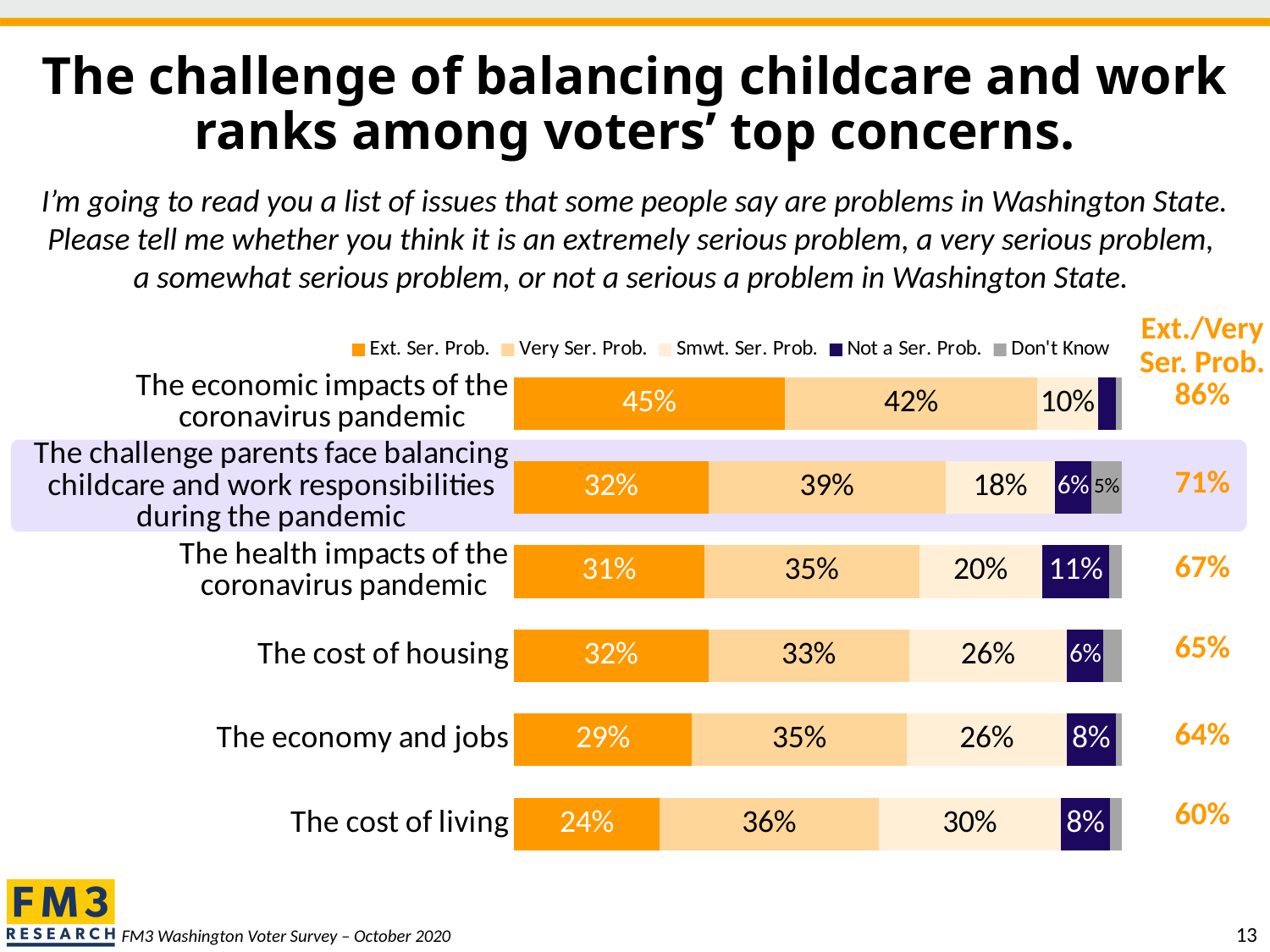
What kind of chart is shown on the slide? Stacked bar chart What is the difference between the Ext./Very Ser. Prob. figures for the economic impacts of the coronavirus pandemic and the childcare and work balancing challenge? 15 percentage points What is the combined Ext./Very Ser. Prob. figure shown for the challenge parents face balancing childcare and work responsibilities during the pandemic? 71% Which issue has the lowest Ext. Ser. Prob. value? The cost of living Which has a larger Very Ser. Prob. value: the challenge parents face balancing childcare and work, or the health impacts of the coronavirus pandemic? The challenge parents face balancing childcare and work responsibilities during the pandemic Which issue has the highest Ext. Ser. Prob. value? The economic impacts of the coronavirus pandemic What is the Very Ser. Prob. value for the cost of living? 36% How many percentage points higher is the Ext. Ser. Prob. value for the economic impacts of the coronavirus pandemic than for the cost of living? 21 percentage points How many issues are listed in the chart? 6 How many series does the legend list? 5 What percentage of voters rated the economic impacts of the coronavirus pandemic as an extremely serious problem (Ext. Ser. Prob.)? 45% What is the Not a Ser. Prob. value for the health impacts of the coronavirus pandemic? 11%